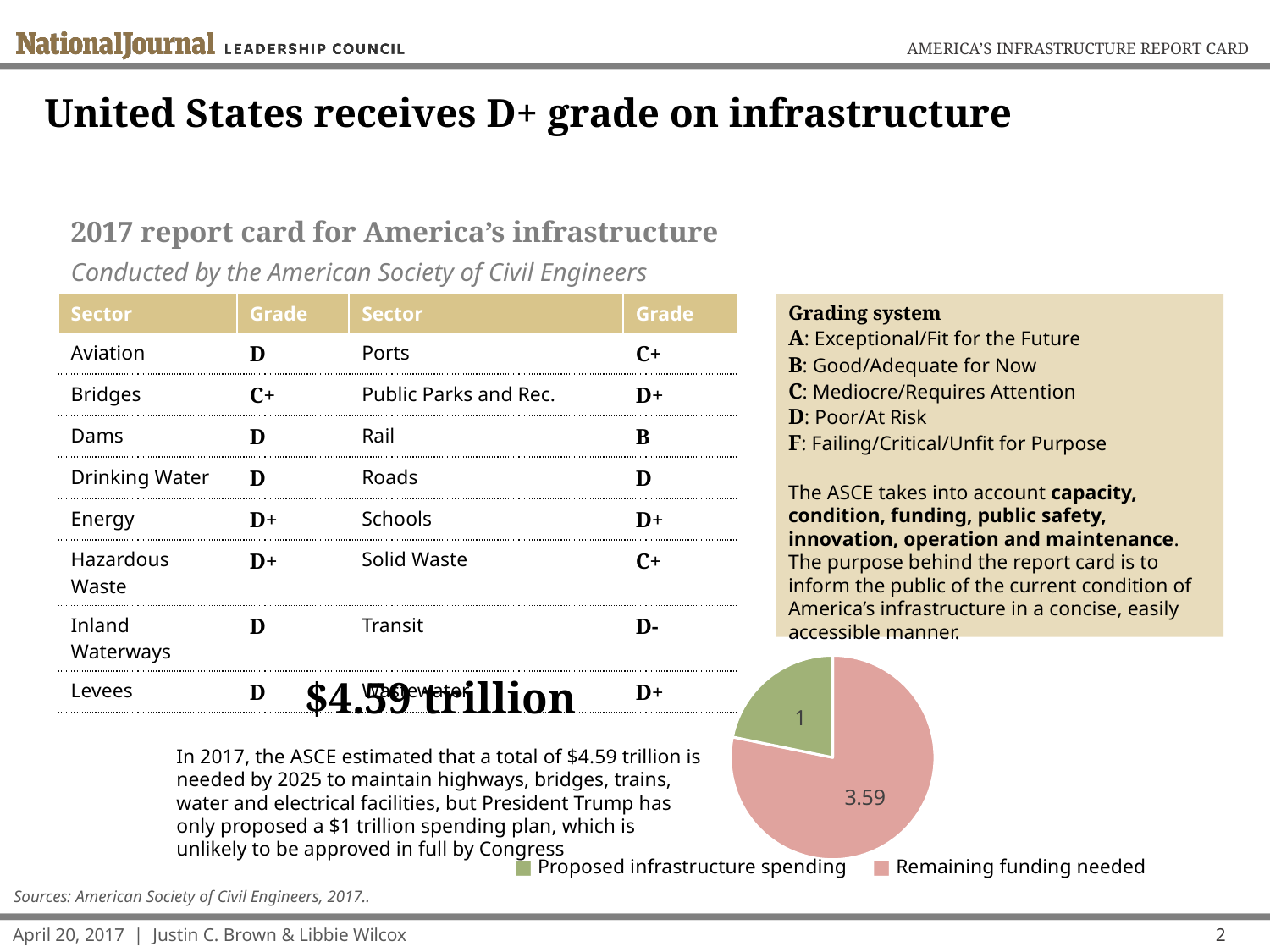
What is the total of the two slice values in the pie chart? 4.59 How many entries does the pie chart's legend list? 2 What kind of chart is shown on the slide? Pie chart What is the value of the 'Remaining funding needed' slice in the pie chart? 3.59 How many slices does the pie chart have? 2 What colour is the 'Remaining funding needed' slice in the pie chart? Pink Which slice of the pie chart is the smallest? Proposed infrastructure spending Which slice of the pie chart is the largest? Remaining funding needed What colour is the 'Proposed infrastructure spending' slice in the pie chart? Green Which is larger in the pie chart: 'Proposed infrastructure spending' or 'Remaining funding needed'? Remaining funding needed What is the difference between the 'Remaining funding needed' and 'Proposed infrastructure spending' values in the pie chart? 2.59 What is the value of the 'Proposed infrastructure spending' slice in the pie chart? 1